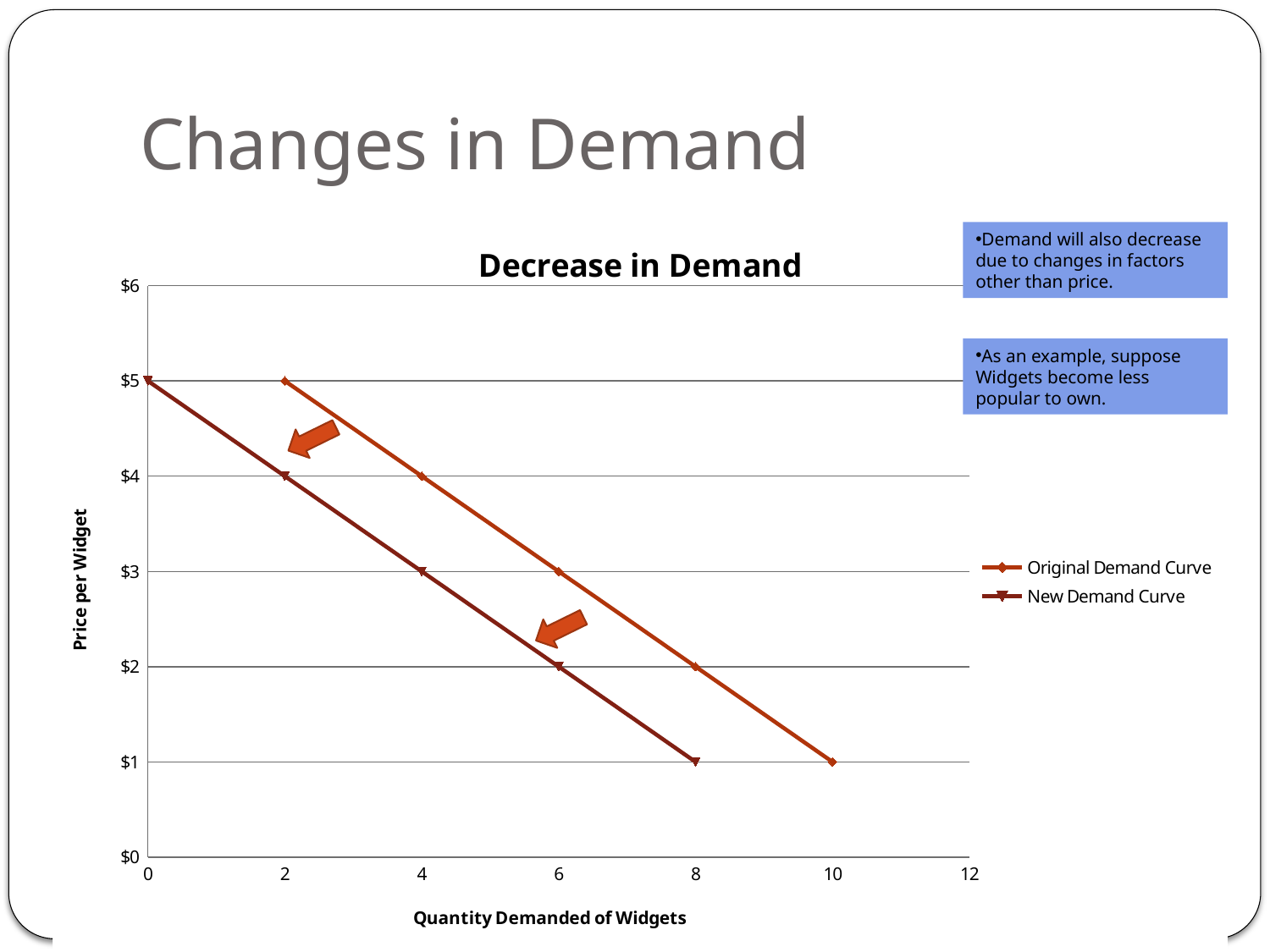
On the Original Demand Curve, what quantity is demanded at a price of $3? 6 How many data points are plotted on the New Demand Curve? 5 How many series does the chart legend list? 2 What is the label of the vertical axis? Price per Widget On the New Demand Curve, what quantity is demanded at a price of $3? 4 At a price of $4, which series shows the larger quantity demanded, the Original Demand Curve or the New Demand Curve? Original Demand Curve At a price of $2, how much larger is the quantity demanded on the Original Demand Curve than on the New Demand Curve? 2 What kind of chart is shown on the slide? line chart As quantity demanded increases along the x axis, does the price on the Original Demand Curve rise or fall? fall On the Original Demand Curve, what is the price when the quantity demanded is 10? $1 On the New Demand Curve, what is the price when the quantity demanded is 0? $5 What is the title of the chart? Decrease in Demand